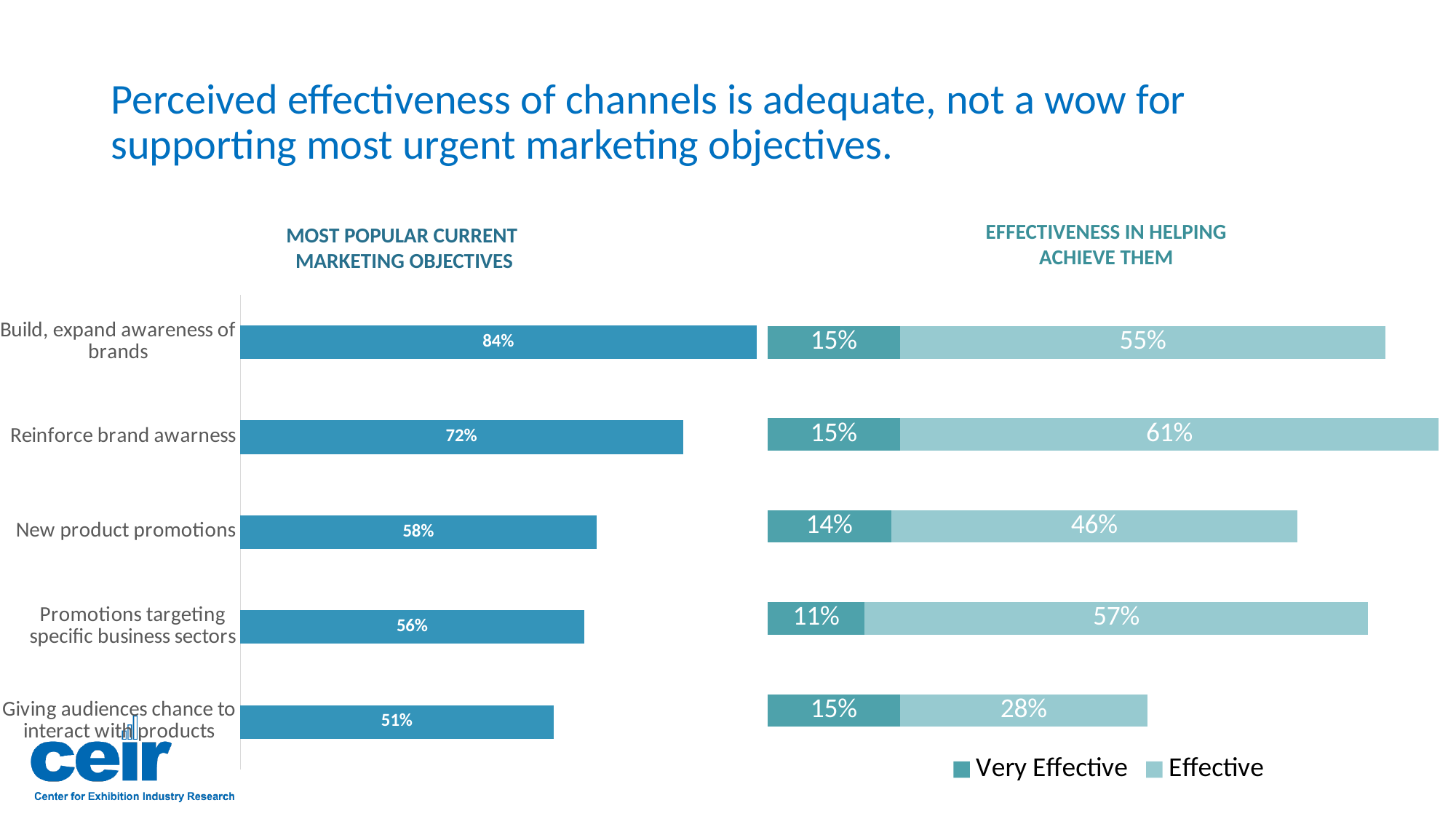
In the 'Most Popular Current Marketing Objectives' chart, which objective has the lowest value? Giving audiences chance to interact with products How many series does the legend of the 'Effectiveness in Helping Achieve Them' chart list? 2 In the 'Most Popular Current Marketing Objectives' chart, what is the difference between 'Build, expand awareness of brands' and 'Reinforce brand awarness'? 12% In the 'Effectiveness in Helping Achieve Them' chart, what is the total of the stacked bar for 'Giving audiences chance to interact with products'? 43% In the 'Most Popular Current Marketing Objectives' chart, what is the value for 'Build, expand awareness of brands'? 84% How many objectives are shown in the 'Most Popular Current Marketing Objectives' chart? 5 What kind of chart is the 'Most Popular Current Marketing Objectives' chart? Bar chart In the 'Most Popular Current Marketing Objectives' chart, what is the value for 'New product promotions'? 58% In the 'Effectiveness in Helping Achieve Them' chart, what is the 'Effective' value for 'Reinforce brand awarness'? 61% In the 'Effectiveness in Helping Achieve Them' chart, what is the total of the stacked bar for 'Reinforce brand awarness'? 76% In the 'Effectiveness in Helping Achieve Them' chart, what is the 'Very Effective' value for 'Promotions targeting specific business sectors'? 11% In the 'Effectiveness in Helping Achieve Them' chart, which objective has the lowest 'Effective' value? Giving audiences chance to interact with products